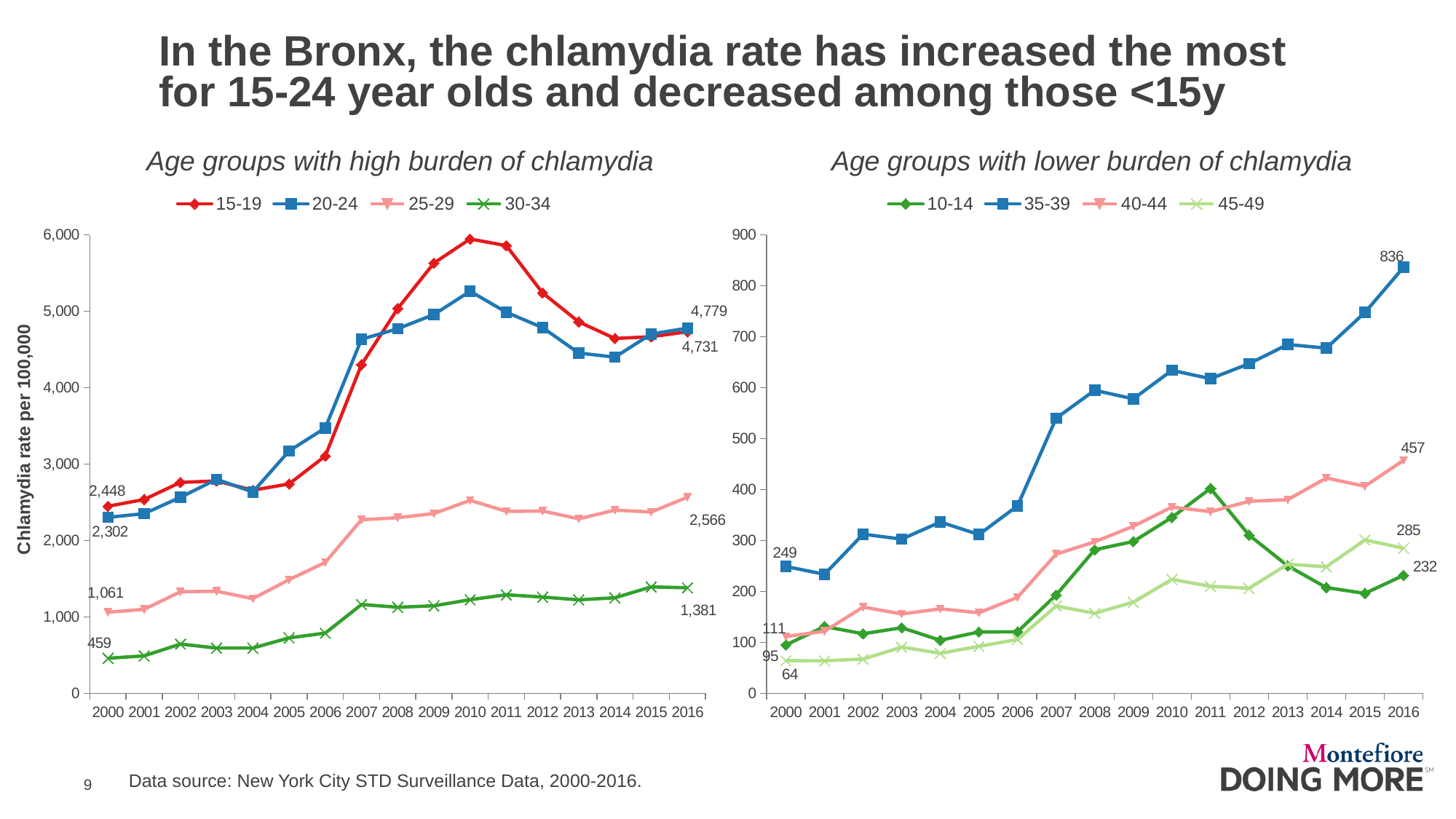
In the right chart (Age groups with lower burden of chlamydia), what is the chlamydia rate for the 45-49 age group in 2000? 64 In the left chart (Age groups with high burden of chlamydia), by how much did the rate for the 30-34 age group increase from 2000 to 2016? 922 In the left chart (Age groups with high burden of chlamydia), is the rate for the 15-19 age group in 2010 greater or less than 5,000? greater In the left chart (Age groups with high burden of chlamydia), how many series does the legend list? 4 In the right chart (Age groups with lower burden of chlamydia), which has the higher rate in 2016: the 40-44 or the 45-49 age group? 40-44 In the right chart (Age groups with lower burden of chlamydia), by how much did the rate for the 35-39 age group increase from 2000 to 2016? 587 In the right chart (Age groups with lower burden of chlamydia), which age group has the highest rate in 2016? 35-39 In the right chart (Age groups with lower burden of chlamydia), what is the chlamydia rate for the 10-14 age group in 2016? 232 In the right chart (Age groups with lower burden of chlamydia), what is the chlamydia rate for the 35-39 age group in 2016? 836 In the left chart (Age groups with high burden of chlamydia), what is the chlamydia rate for the 25-29 age group in 2016? 2,566 In the left chart (Age groups with high burden of chlamydia), what is the chlamydia rate for the 30-34 age group in 2000? 459 What type of chart is used on this slide? Line chart